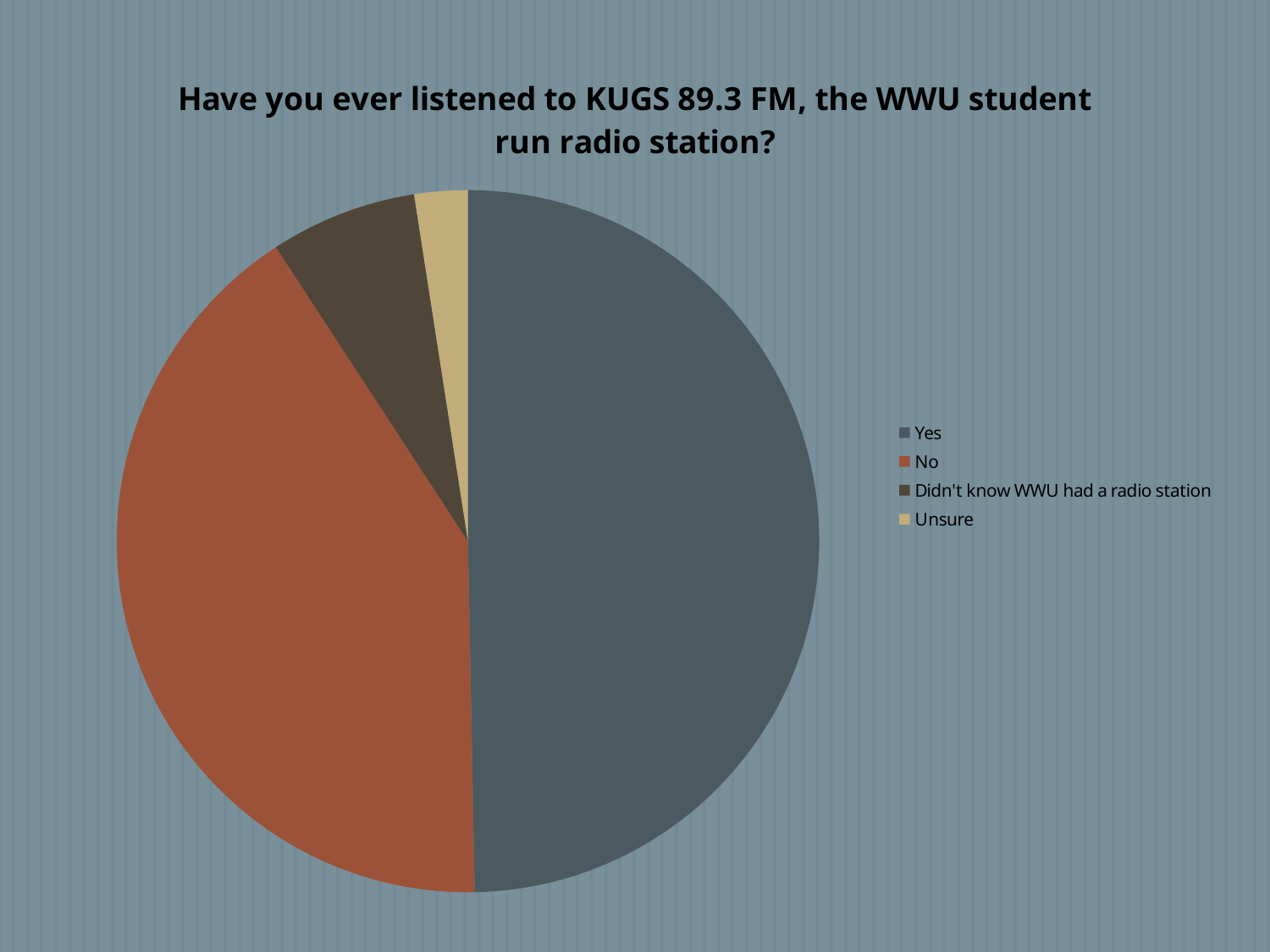
What kind of chart is shown on the slide? pie chart What is the title of the chart? Have you ever listened to KUGS 89.3 FM, the WWU student run radio station? Which response has the smallest slice of the pie? Unsure Which slice is larger, No or Didn't know WWU had a radio station? No Which slice is larger, Yes or No? Yes Which slice is larger, Didn't know WWU had a radio station or Unsure? Didn't know WWU had a radio station Which response has the largest slice of the pie? Yes Which response is shown in the legend directly after No? Didn't know WWU had a radio station How many slices does the pie chart have? 4 How many entries does the legend list? 4